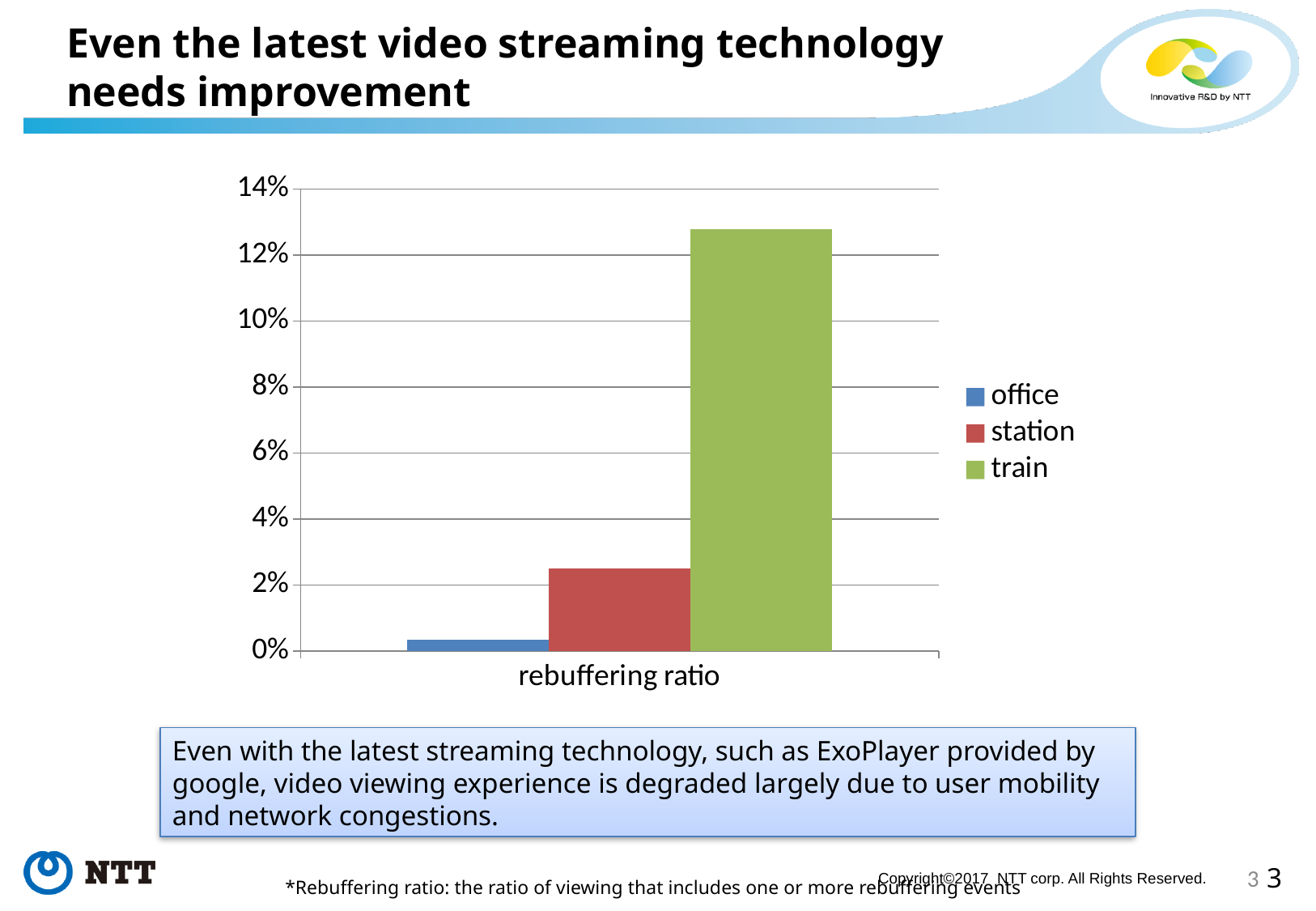
Is the rebuffering ratio for station greater or less than 4%? less What kind of chart is shown on the slide? bar chart Is the rebuffering ratio for office greater or less than 2%? less What colour is the bar for the train series? green Which has a larger rebuffering ratio, office or station? station How many categories are shown on the x axis? 1 Which has a larger rebuffering ratio, station or train? train How many series does the legend list? 3 Which series has the lowest rebuffering ratio? office What is the label on the x axis of the chart? rebuffering ratio Which series has the highest rebuffering ratio? train Is the rebuffering ratio for train greater or less than 12%? greater